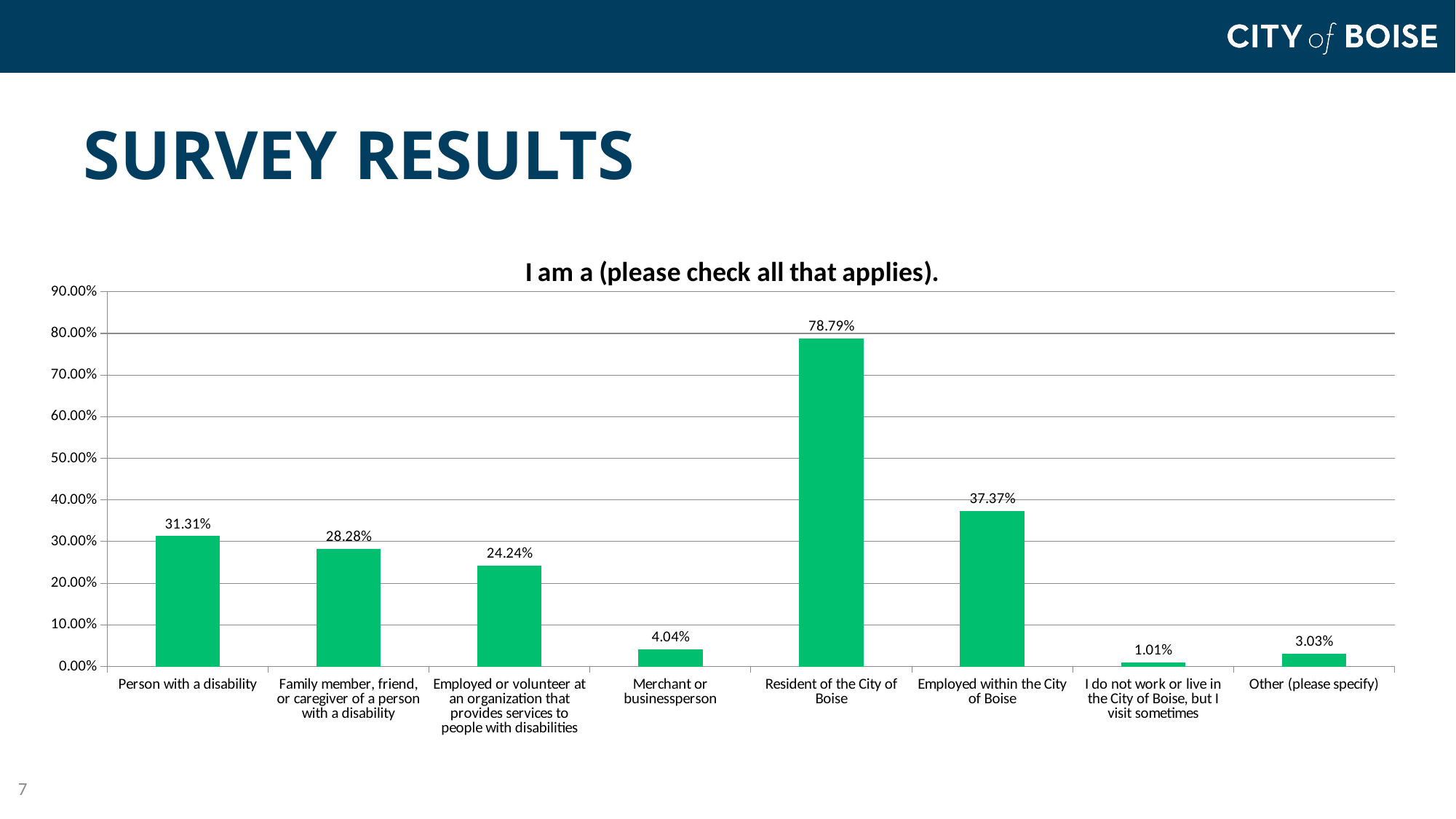
Is the value for 'Employed within the City of Boise' greater or less than 30.00%? greater How many categories are shown in the chart? 8 What type of chart is shown on the slide? Bar chart What is the value for 'Resident of the City of Boise'? 78.79% Which category has the highest value? Resident of the City of Boise What is the difference between 'Resident of the City of Boise' and 'Employed within the City of Boise'? 41.42% What percentage of respondents identified as a person with a disability? 31.31% What percentage of respondents selected 'Merchant or businessperson'? 4.04% What is the title of the chart? I am a (please check all that applies). What is the value for 'Other (please specify)'? 3.03% Which is larger: 'Person with a disability' or 'Family member, friend, or caregiver of a person with a disability'? Person with a disability Which category has the lowest value? I do not work or live in the City of Boise, but I visit sometimes